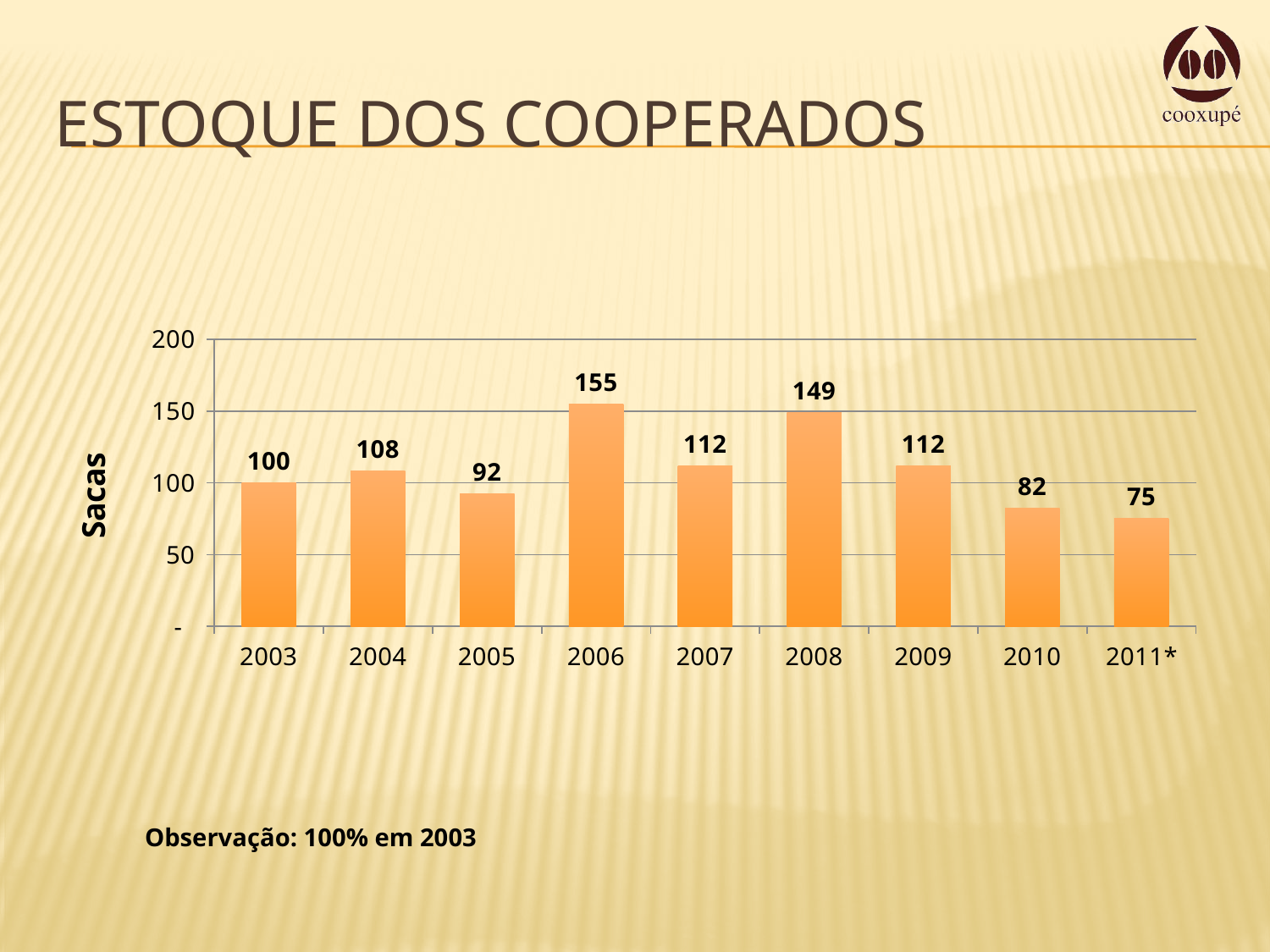
What is the value for 2005? 92 What kind of chart is shown on the slide? bar chart What is the value for 2011*? 75 What is the difference between the values for 2003 and 2010? 18 How many years are shown on the x axis? 9 Which is larger, the value for 2004 or the value for 2009? 2009 What is the difference between the values for 2006 and 2008? 6 What is the value for 2006? 155 Which year has the highest value? 2006 What is the label of the vertical axis? Sacas Which year has the lowest value? 2011* Is the value for 2008 greater or less than 100? greater